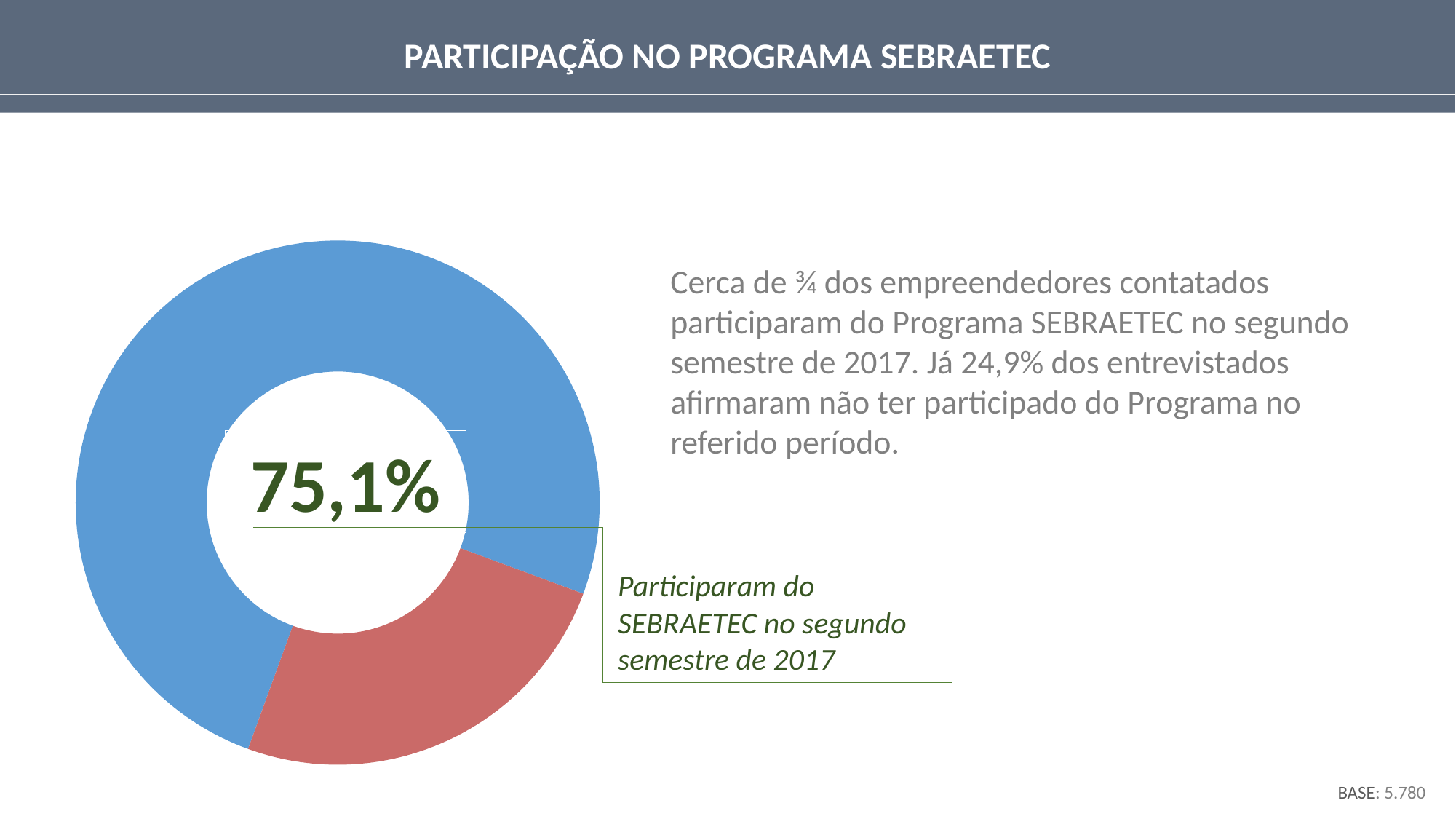
What colour is the slice representing those who participated in SEBRAETEC? blue Which slice of the chart is the largest? Participaram do SEBRAETEC no segundo semestre de 2017 (blue) Is the share of the blue slice greater or less than 50%? greater What is the title of the slide containing the chart? PARTICIPAÇÃO NO PROGRAMA SEBRAETEC What percentage of respondents participated in SEBRAETEC in the second semester of 2017, according to the chart? 75,1% What share of respondents did not participate in the program, as stated on the slide? 24,9% Is the share of the red slice greater or less than 50%? less What kind of chart is shown on the slide? pie chart (donut) How many slices does the donut chart have? 2 Which slice is larger, the blue one or the red one? blue